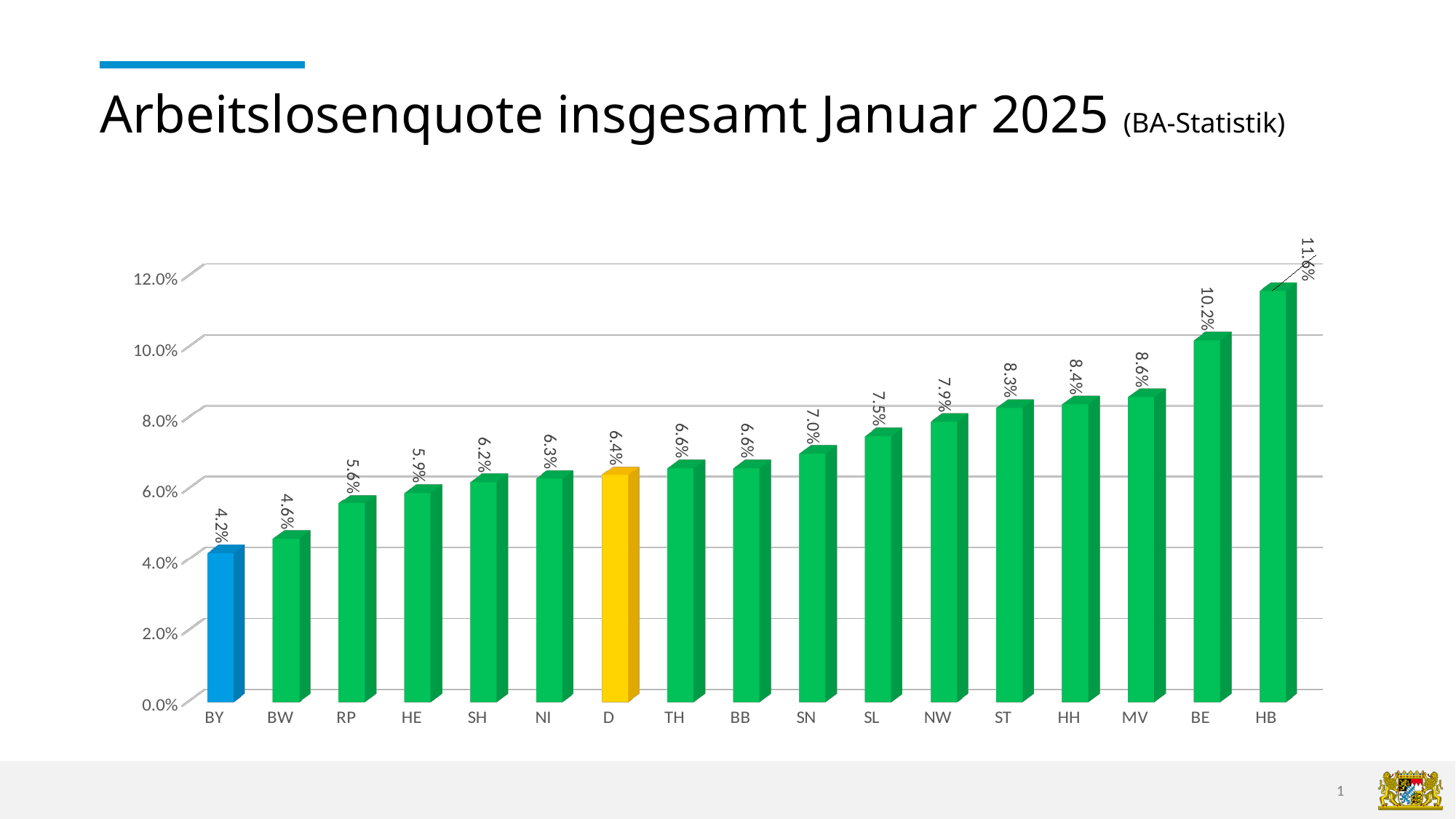
Which has a larger value, SN or NW? NW What is the difference between the values for HB and BY? 7.4% Which category's bar is coloured yellow? D Which category has the highest value? HB What is the unemployment rate shown for BY? 4.2% What kind of chart is shown on the slide? bar chart Do the values rise or fall from left to right along the x axis? rise Is the value for MV greater or less than 8.0%? greater What is the value shown for BE? 10.2% How many categories are shown on the x axis? 17 What is the value shown for D? 6.4% Which category has the lowest value? BY